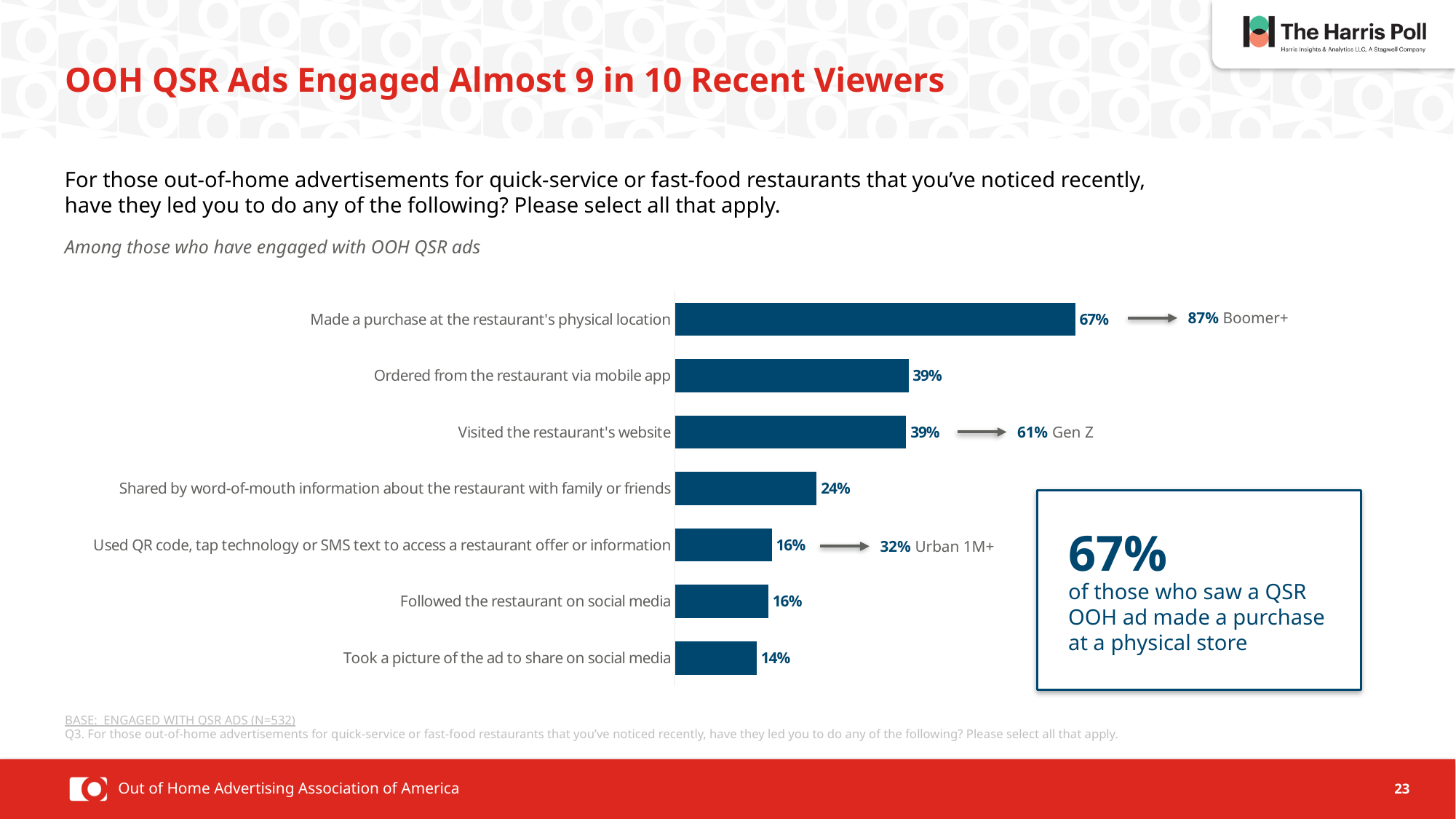
Which action has the lowest percentage in the chart? Took a picture of the ad to share on social media Which action has the highest percentage in the chart? Made a purchase at the restaurant's physical location What percentage of respondents made a purchase at the restaurant's physical location? 67% What percentage of respondents ordered from the restaurant via mobile app? 39% What type of chart is shown on the slide? Bar chart What percentage of Boomer+ respondents made a purchase at the restaurant's physical location, according to the callout? 87% How many actions (categories) are shown in the bar chart? 7 What percentage of respondents took a picture of the ad to share on social media? 14% What percentage of Gen Z respondents visited the restaurant's website, according to the callout? 61% What is the difference in percentage points between making a purchase at the physical location and ordering via mobile app? 28 What percentage of respondents shared word-of-mouth information about the restaurant with family or friends? 24% Which is larger: the percentage who visited the restaurant's website or the percentage who followed the restaurant on social media? Visited the restaurant's website